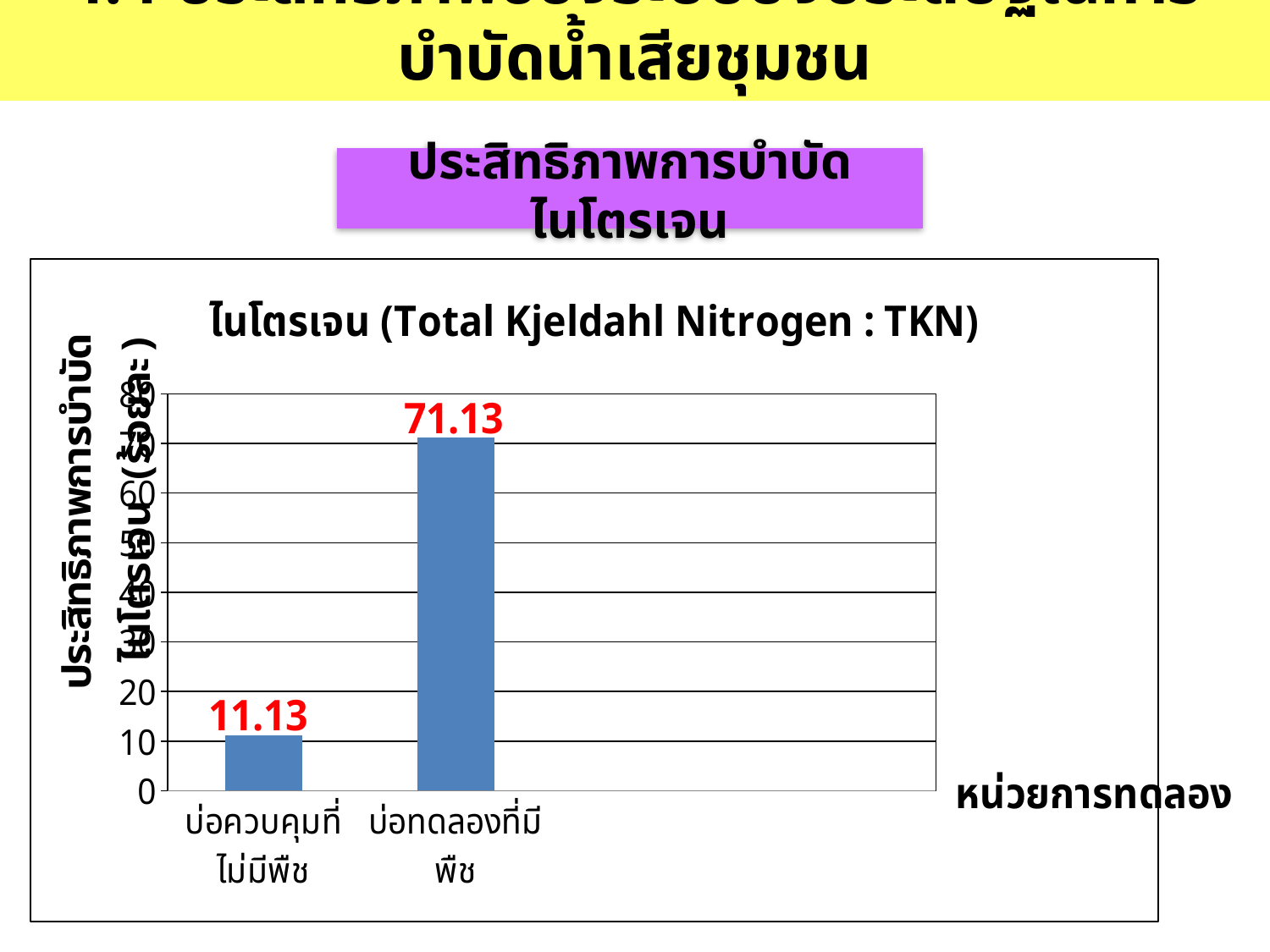
Is the value for บ่อทดลองที่มีพืช greater or less than 60? greater Which category has the lowest value? บ่อควบคุมที่ไม่มีพืช What is the value for บ่อควบคุมที่ไม่มีพืช? 11.13 What colour are the bars in the chart? blue What is the difference between the values for บ่อทดลองที่มีพืช and บ่อควบคุมที่ไม่มีพืช? 60 What is the title of the chart? ไนโตรเจน (Total Kjeldahl Nitrogen : TKN) How many categories are shown on the x axis? 2 Which category has the highest value? บ่อทดลองที่มีพืช Which is larger, the value for บ่อควบคุมที่ไม่มีพืช or the value for บ่อทดลองที่มีพืช? บ่อทดลองที่มีพืช Is the value for บ่อควบคุมที่ไม่มีพืช greater or less than 20? less What is the value for บ่อทดลองที่มีพืช? 71.13 What kind of chart is shown? bar chart